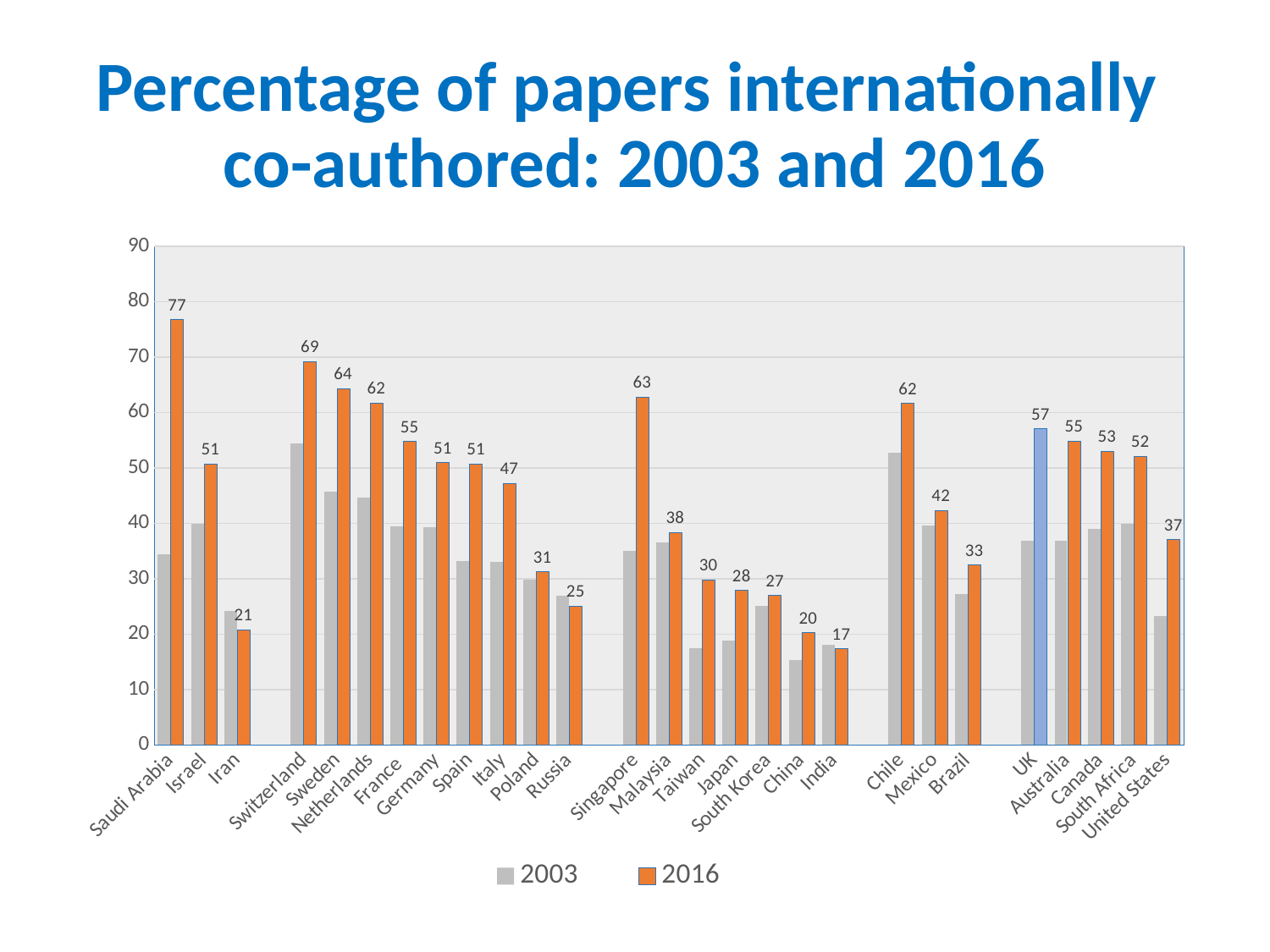
What kind of chart is shown on the slide? Bar chart What is the difference between the 2016 values for Saudi Arabia and Iran? 56 What is the 2016 value for Saudi Arabia? 77 How many countries are shown on the x axis? 27 Is the 2003 value for Taiwan greater or less than 20? less Which has a larger 2016 value, Switzerland or Sweden? Switzerland What is the 2016 value for Singapore? 63 What is the 2016 value for the UK? 57 How many series does the legend list? 2 Which country has the lowest 2016 value? India Is the 2003 value for Switzerland greater or less than 50? greater Which country has the highest 2016 value? Saudi Arabia